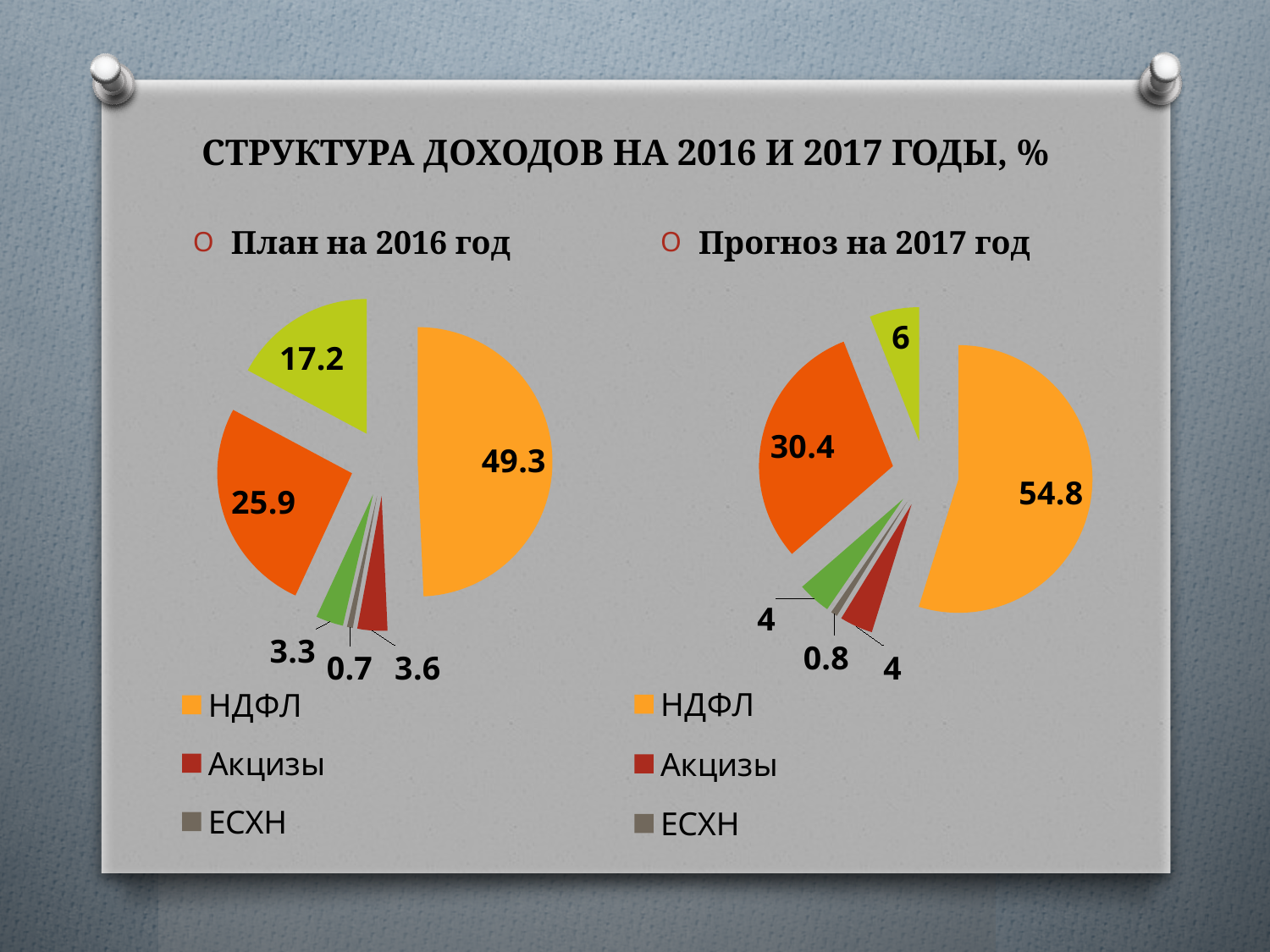
In the 'Прогноз на 2017 год' chart, what is the value for НДФЛ? 54.8 In the 'План на 2016 год' chart, what is the value for Акцизы? 3.6 In the 'План на 2016 год' chart, what is the value for ЕСХН? 0.7 In the 'Прогноз на 2017 год' chart, which is larger: Акцизы or ЕСХН? Акцизы In the 'Прогноз на 2017 год' chart, which category has the smallest slice? ЕСХН How many slices does the 'План на 2016 год' pie chart have? 6 In the 'План на 2016 год' chart, what is the value for НДФЛ? 49.3 In the 'Прогноз на 2017 год' chart, what is the value for Акцизы? 4 In the 'Прогноз на 2017 год' chart, what is the value for ЕСХН? 0.8 By how much is the НДФЛ value in the 'Прогноз на 2017 год' chart higher than in the 'План на 2016 год' chart? 5.5 What kind of chart is the 'План на 2016 год' chart? pie chart In the 'План на 2016 год' chart, which category has the largest slice? НДФЛ